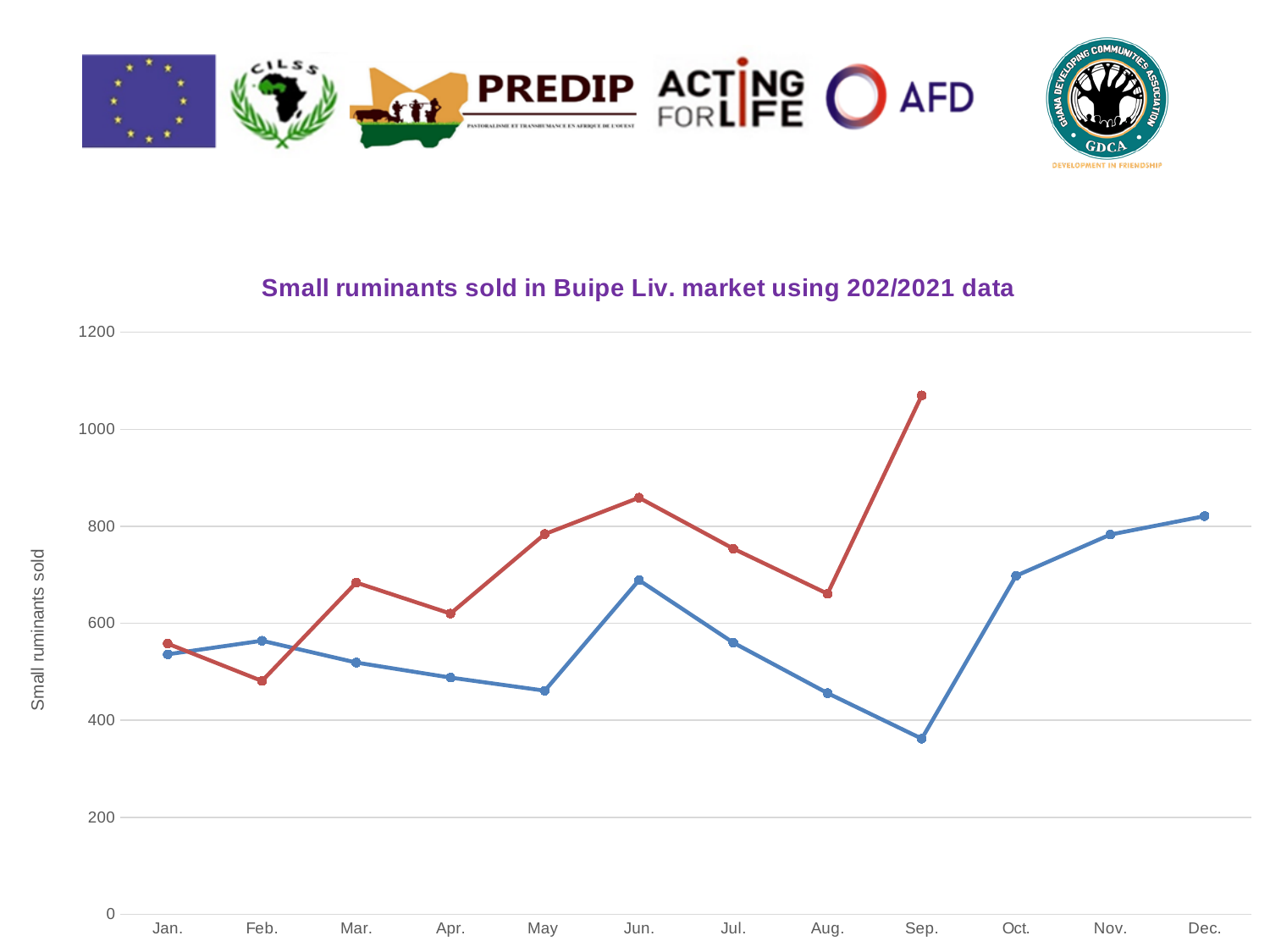
Is the value of the blue line for Dec. greater or less than 800? greater In Jun., which line has the larger value, the red line or the blue line? red line What kind of chart is shown on the slide? line chart How many months are shown along the x axis? 12 Is the value of the blue line for Sep. greater or less than 400? less In which month does the blue line reach its lowest value? Sep. Does the blue line rise or fall from Sep. to Dec.? rise What is the title of the chart? Small ruminants sold in Buipe Liv. market using 202/2021 data In which month does the red line reach its lowest value? Feb. In which month does the red line reach its highest value? Sep. Is the value of the red line for Sep. greater or less than 1000? greater What is the label on the vertical axis? Small ruminants sold